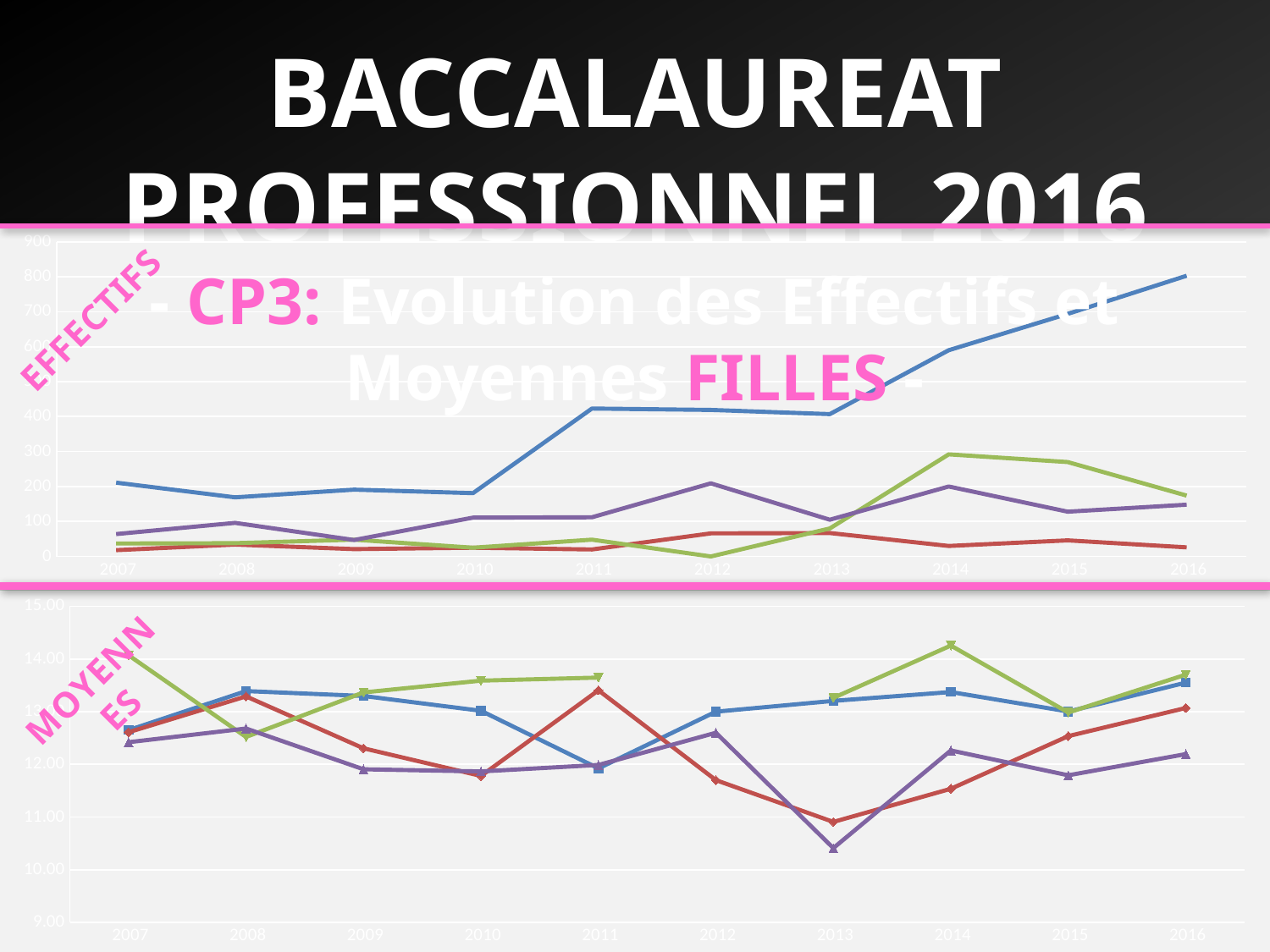
In the bottom chart, in which year does the purple line reach its lowest value? 2013 What kind of chart is the bottom chart on the slide? line chart In the top chart, does the blue line rise or fall overall from 2007 to 2016? rise What kind of chart is the top chart on the slide? line chart In the bottom chart, is the value of the purple line in 2013 greater or less than 11.00? less How many years are shown along the x axis of the bottom chart? 10 How many years are shown along the x axis of the top chart? 10 In the top chart, in which year does the blue line reach its highest value? 2016 What is the first year shown on the x axis of the top chart? 2007 In the top chart, is the value of the blue line in 2016 greater or less than 700? greater In the top chart, which line is higher in 2016, the blue line or the green line? the blue line In the top chart, is the value of the blue line in 2007 greater or less than 300? less